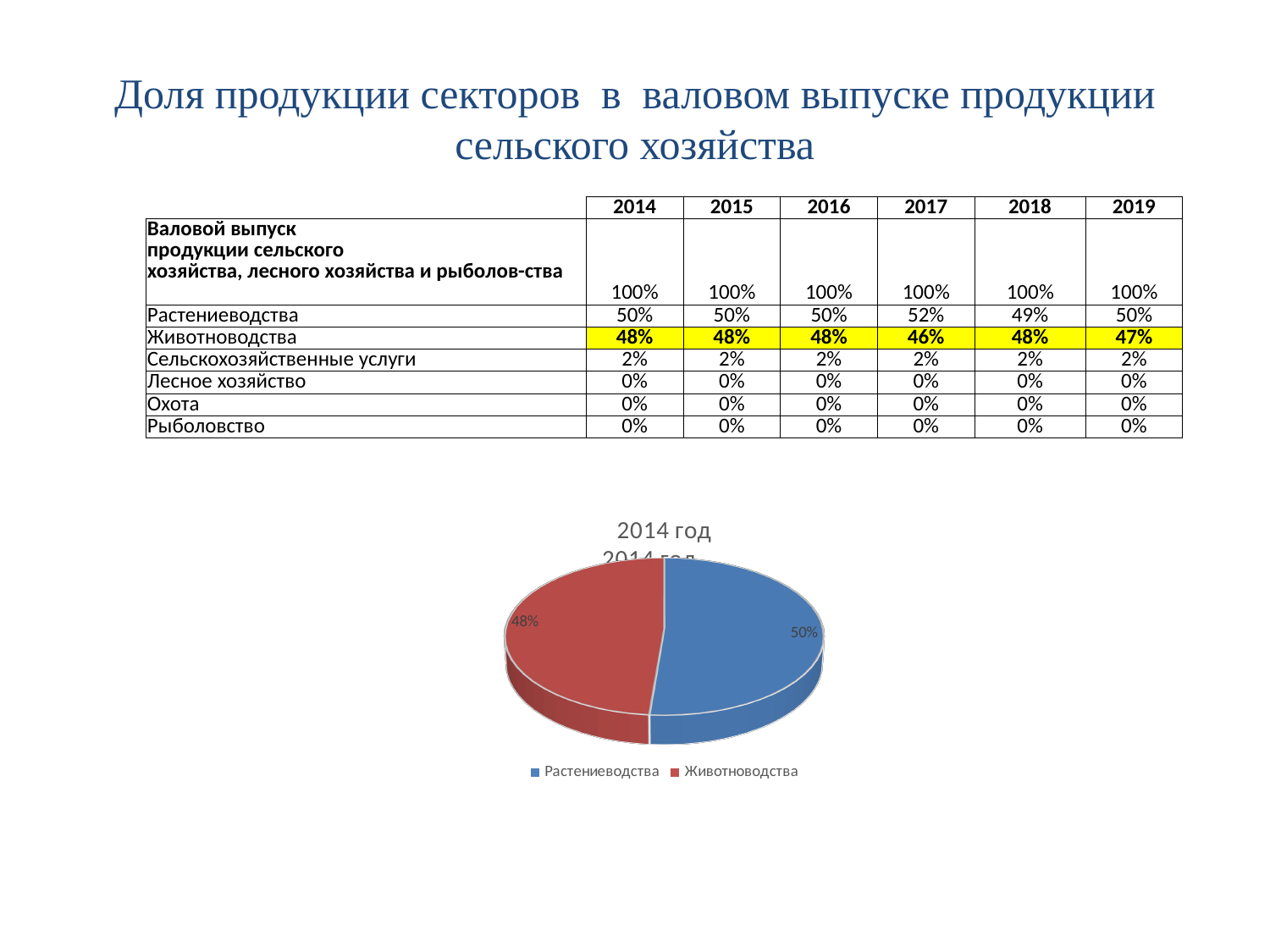
Which slice of the pie chart is the largest? Растениеводства What kind of chart is shown on the slide? pie chart What colour is the Животноводства slice in the pie chart? red What is the title of the pie chart? 2014 год What share of the pie chart does Растениеводства have? 50% In the pie chart, is the Растениеводства slice larger or smaller than the Животноводства slice? larger What share of the pie chart does Животноводства have? 48% How many slices does the pie chart have? 2 Which slice of the pie chart is the smallest? Животноводства How many entries does the pie chart legend list? 2 What is the difference between the Растениеводства and Животноводства slices in the pie chart? 2%